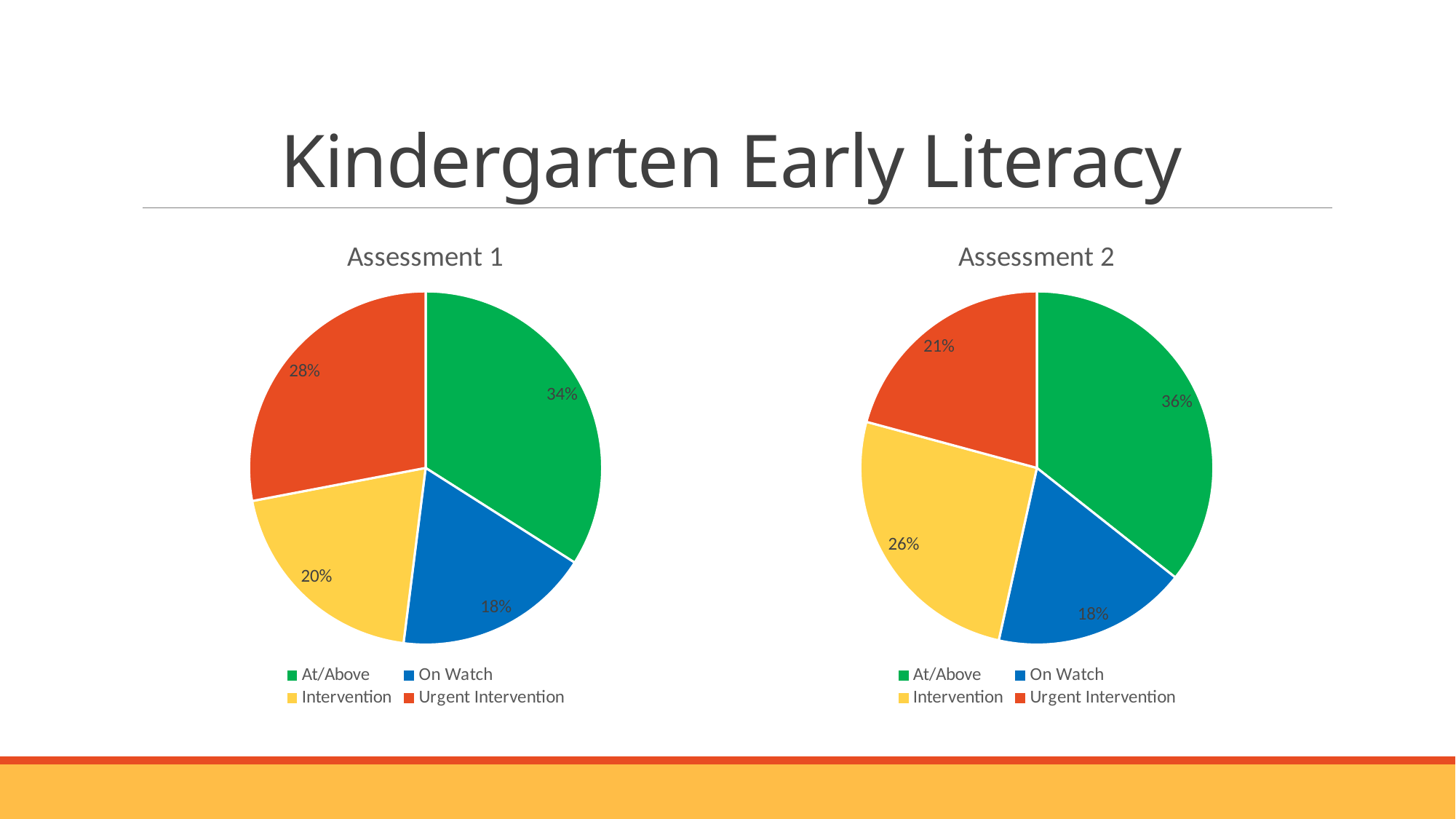
In the Assessment 2 chart, what percentage is Intervention? 26% In the Assessment 1 chart, which category has the largest share? At/Above Which is larger: the Intervention share in Assessment 1 or in Assessment 2? Assessment 2 In the Assessment 2 chart, which colour represents On Watch? Blue What type of chart is the Assessment 1 chart? Pie chart What is the difference between the Urgent Intervention share in Assessment 1 and in Assessment 2? 7 percentage points In the Assessment 2 chart, what percentage is Urgent Intervention? 21% In the Assessment 1 chart, what percentage is At/Above? 34% How many categories does the Assessment 2 chart show? 4 In the Assessment 1 chart, which category has the smallest share? On Watch In the Assessment 1 chart, what percentage is Intervention? 20% In the Assessment 2 chart, which category has the smallest share? On Watch